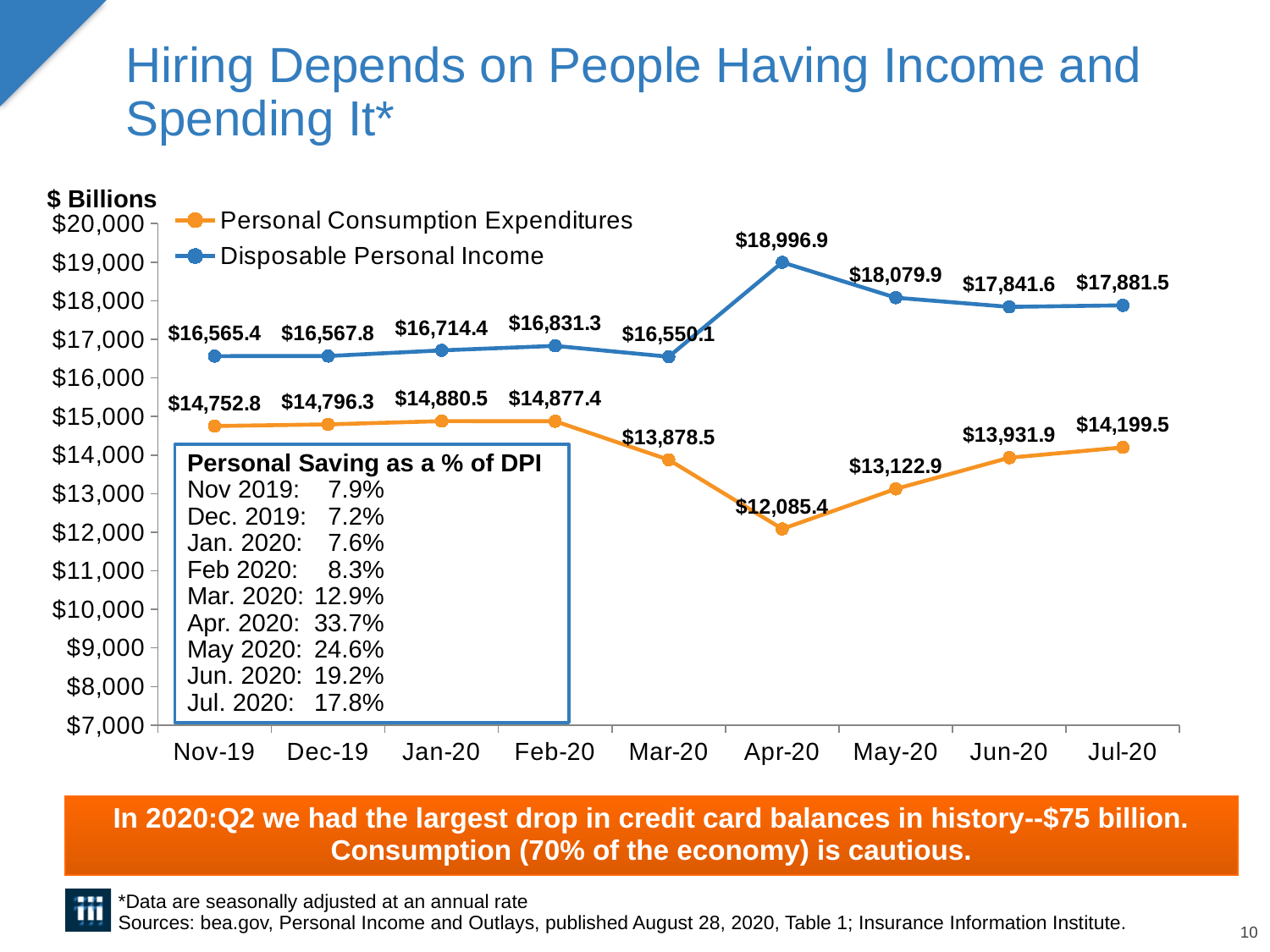
In which month is Disposable Personal Income highest? Apr-20 By how much did Personal Consumption Expenditures increase from Jun-20 to Jul-20? $267.6 What is the Personal Consumption Expenditures value for Jul-20? $14,199.5 What kind of chart is shown on the slide? line chart What is the Personal Consumption Expenditures value for Mar-20? $13,878.5 Is the Personal Consumption Expenditures value for Apr-20 greater or less than $13,000? less How many series does the legend list? 2 What is the Disposable Personal Income value for Apr-20? $18,996.9 How many months are plotted on the x axis? 9 What is the difference between Disposable Personal Income and Personal Consumption Expenditures in Apr-20? $6,911.5 Which is larger: Disposable Personal Income in May-20 or in Jul-20? May-20 In which month are Personal Consumption Expenditures lowest? Apr-20